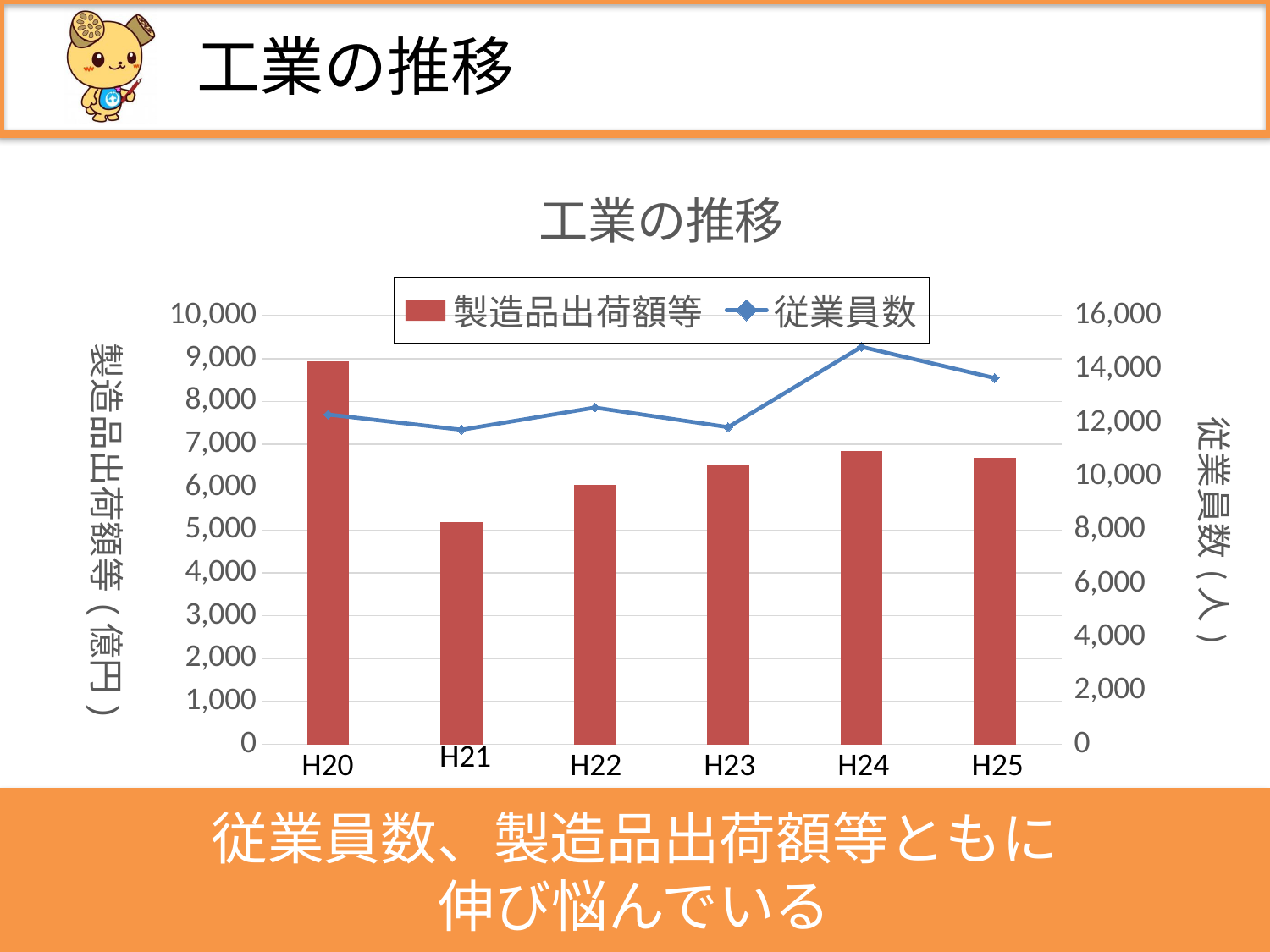
Is the 従業員数 value for H24 greater or less than 14,000? greater Which series is plotted as a line with diamond markers? 従業員数 How many series does the legend list? 2 In which year does the 従業員数 line reach its highest point? H24 Which year has the larger 製造品出荷額等 value, H22 or H23? H23 Is the 製造品出荷額等 value for H20 greater or less than 8,000? greater What kind of chart is shown on the slide? Combined bar and line chart In which year is the 製造品出荷額等 bar the lowest? H21 How many years (categories) are shown on the x axis? 6 Is the 従業員数 value for H21 greater or less than 12,000? less In which year is the 製造品出荷額等 bar the highest? H20